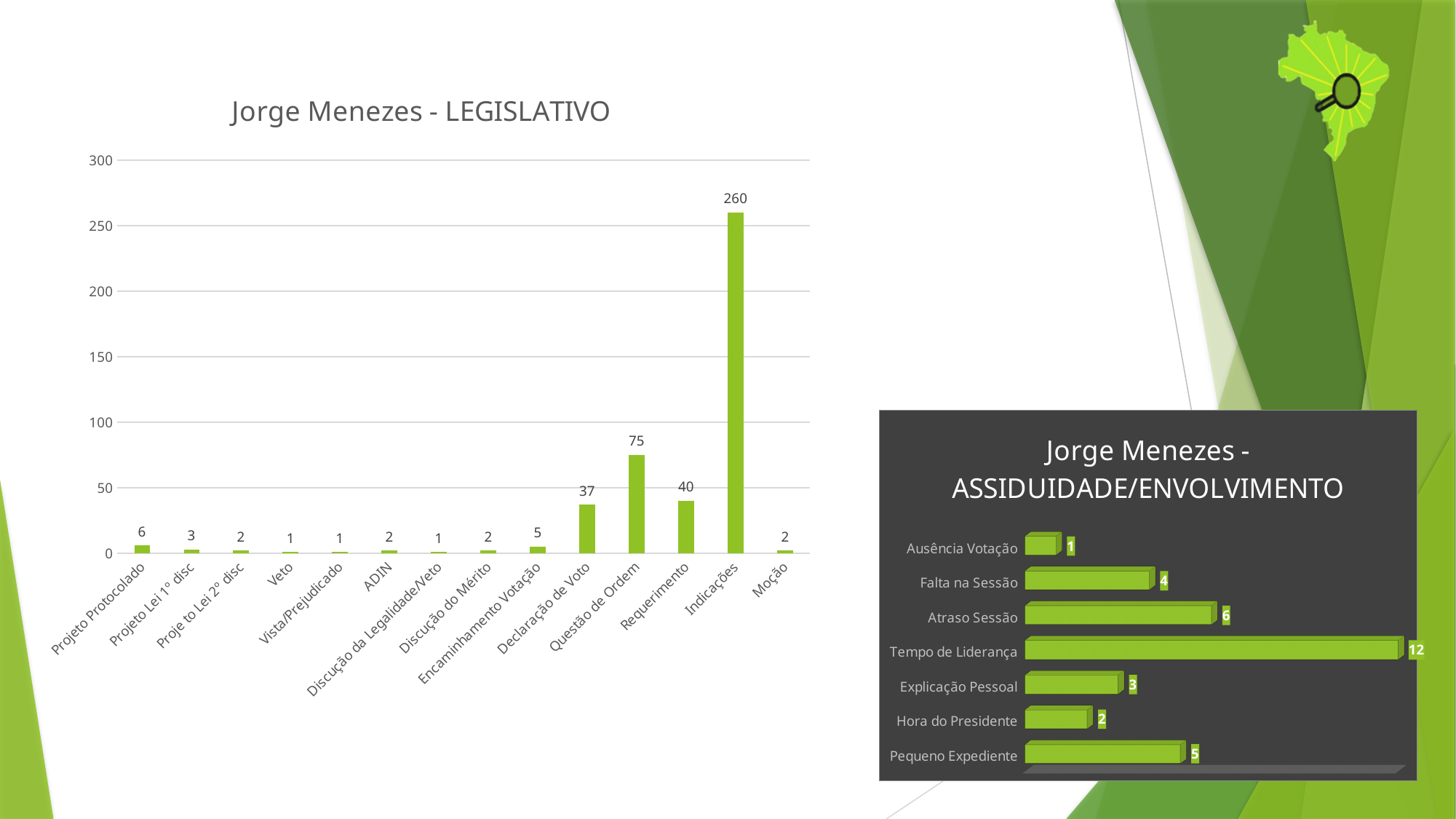
In the 'Jorge Menezes - ASSIDUIDADE/ENVOLVIMENTO' chart, how many categories are shown? 7 In the 'Jorge Menezes - LEGISLATIVO' chart, what is the value for Indicações? 260 In the 'Jorge Menezes - LEGISLATIVO' chart, which category has the highest value? Indicações What kind of chart is 'Jorge Menezes - LEGISLATIVO'? Bar chart In the 'Jorge Menezes - LEGISLATIVO' chart, what is the difference between Requerimento and Declaração de Voto? 3 In the 'Jorge Menezes - ASSIDUIDADE/ENVOLVIMENTO' chart, what is the value for Tempo de Liderança? 12 In the 'Jorge Menezes - LEGISLATIVO' chart, what is the value for Questão de Ordem? 75 In the 'Jorge Menezes - ASSIDUIDADE/ENVOLVIMENTO' chart, what is the difference between Atraso Sessão and Falta na Sessão? 2 In the 'Jorge Menezes - ASSIDUIDADE/ENVOLVIMENTO' chart, which is larger, Pequeno Expediente or Explicação Pessoal? Pequeno Expediente In the 'Jorge Menezes - LEGISLATIVO' chart, which is larger, Questão de Ordem or Requerimento? Questão de Ordem In the 'Jorge Menezes - ASSIDUIDADE/ENVOLVIMENTO' chart, which category has the lowest value? Ausência Votação In the 'Jorge Menezes - LEGISLATIVO' chart, how many categories are shown on the x axis? 14